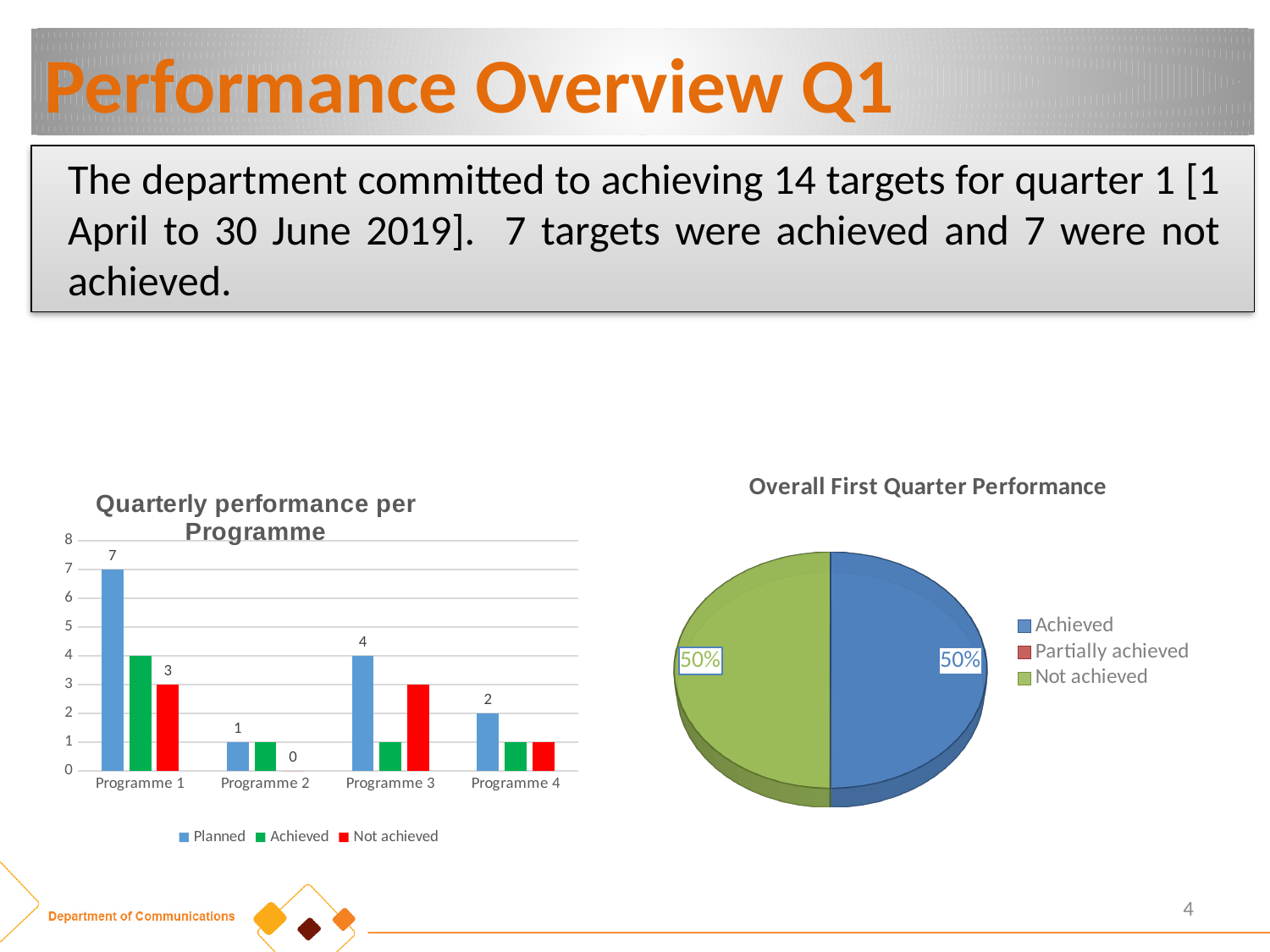
What kind of chart is the 'Overall First Quarter Performance' chart? pie chart What kind of chart is the 'Quarterly performance per Programme' chart? bar chart How many programmes are shown on the x axis of the 'Quarterly performance per Programme' chart? 4 In the 'Overall First Quarter Performance' pie chart, what share is labelled for Achieved? 50% How many series does the legend of the 'Quarterly performance per Programme' chart list? 3 In the 'Quarterly performance per Programme' chart, what is the difference between the Planned values for Programme 1 and Programme 3? 3 In the 'Quarterly performance per Programme' chart, which programme has the highest Planned value? Programme 1 In the 'Quarterly performance per Programme' chart, what is the Not achieved value for Programme 1? 3 In the 'Quarterly performance per Programme' chart, what is the Planned value for Programme 4? 2 In the 'Quarterly performance per Programme' chart, what is the Planned value for Programme 1? 7 In the 'Quarterly performance per Programme' chart, what is the Planned value for Programme 3? 4 In the 'Quarterly performance per Programme' chart, what is the Not achieved value for Programme 2? 0